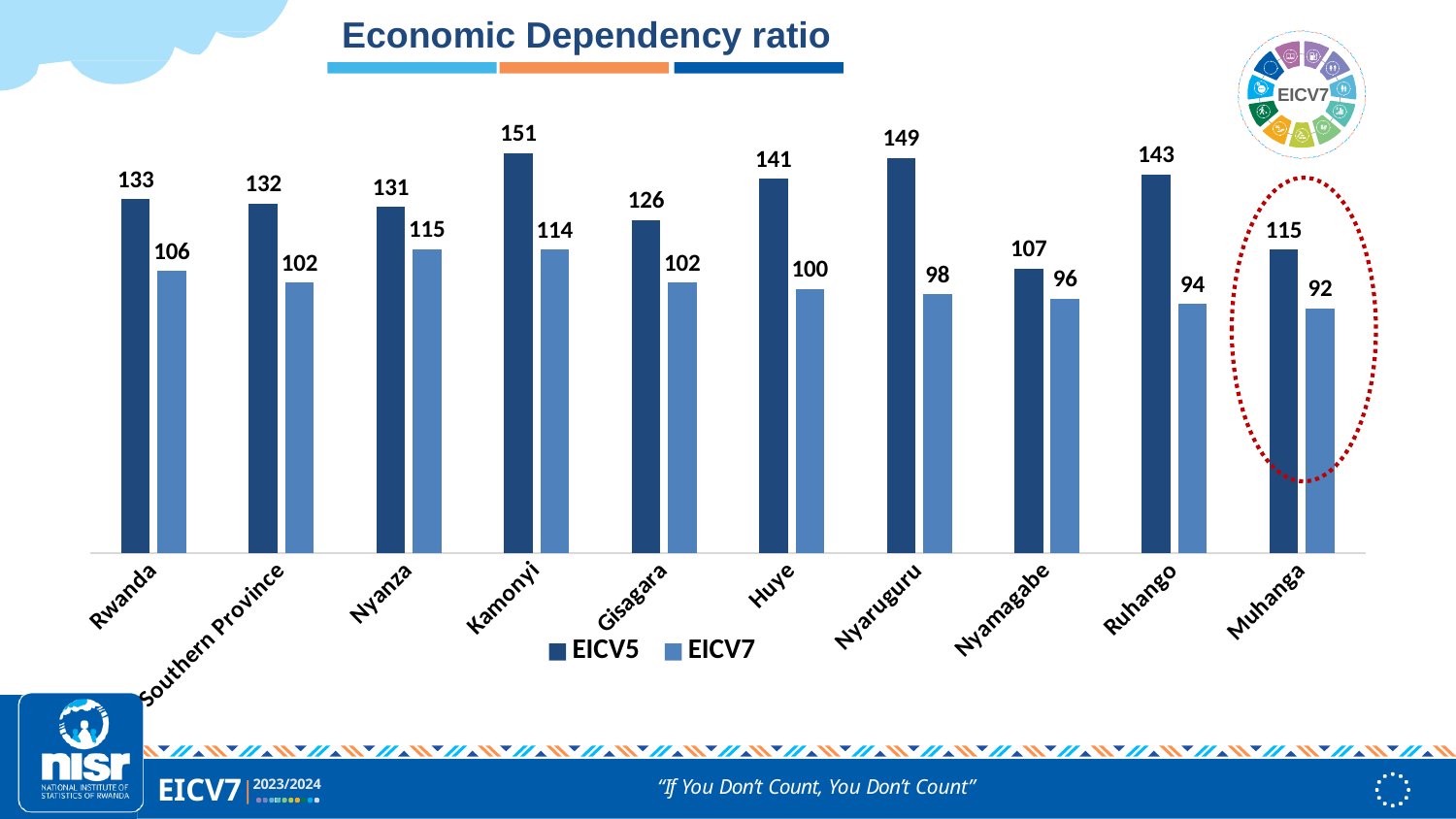
How many categories are shown on the x axis? 10 What is the difference between the EICV5 values for Nyaruguru and Huye? 8 Which category has the lowest EICV7 value? Muhanga What is the EICV7 value for Muhanga? 92 How many series does the legend list? 2 Which category has the highest EICV5 value? Kamonyi Which is larger, the EICV7 value for Nyanza or the EICV7 value for Kamonyi? Nyanza What type of chart is shown on the slide? Bar chart Which category has the lowest EICV5 value? Nyamagabe What is the difference between the EICV5 and EICV7 values for Rwanda? 27 What is the EICV7 value for Nyanza? 115 What is the EICV5 value for Kamonyi? 151